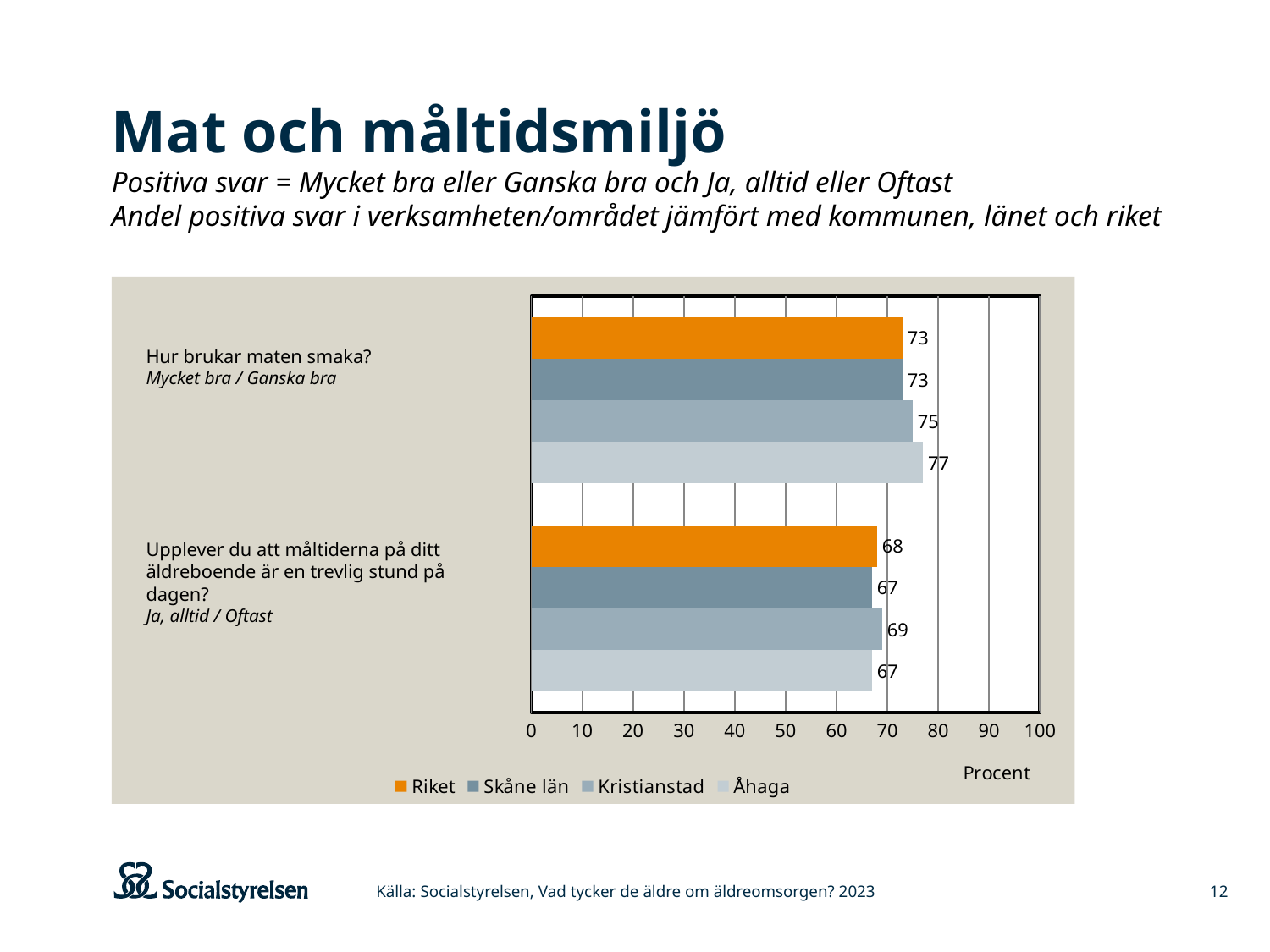
What is the value for Åhaga for the question "Hur brukar maten smaka?"? 77 How many survey questions (categories) are shown in the chart? 2 Which is larger for the question "Upplever du att måltiderna på ditt äldreboende är en trevlig stund på dagen?": the value for Riket or the value for Åhaga? Riket How many series does the legend list? 4 Which series has the highest value for the question "Hur brukar maten smaka?"? Åhaga Which series has the highest value for the question "Upplever du att måltiderna på ditt äldreboende är en trevlig stund på dagen?"? Kristianstad What is the difference between the Åhaga value and the Riket value for the question "Hur brukar maten smaka?"? 4 What is the label of the x axis? Procent What kind of chart is shown on the slide? bar chart What is the value for Kristianstad for the question "Upplever du att måltiderna på ditt äldreboende är en trevlig stund på dagen?"? 69 What is the value for Skåne län for the question "Upplever du att måltiderna på ditt äldreboende är en trevlig stund på dagen?"? 67 What is the value for Riket for the question "Hur brukar maten smaka?"? 73